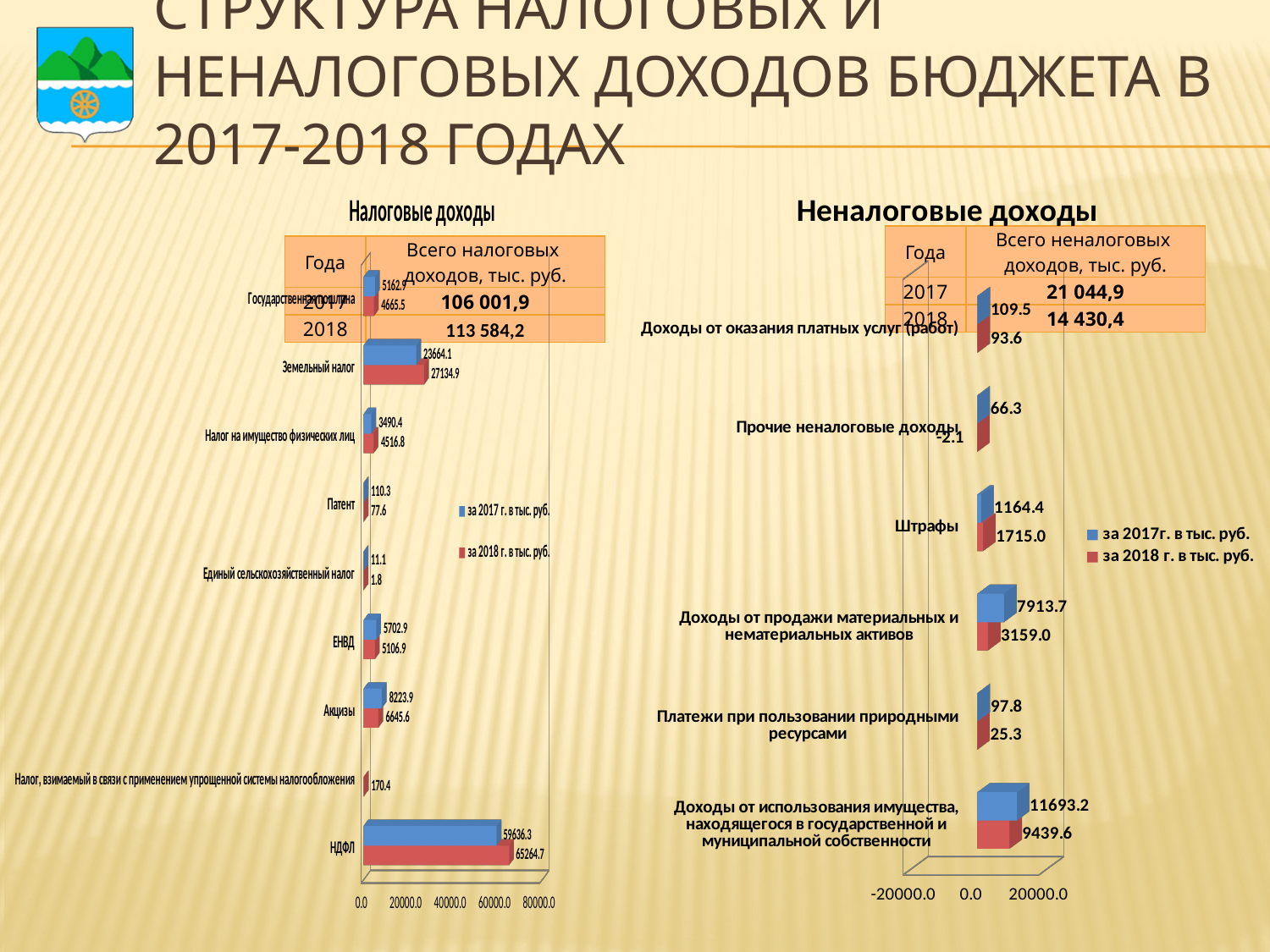
What kind of chart is the 'Неналоговые доходы' chart? Bar chart On the 'Налоговые доходы' chart, which category has the highest value for 2017? НДФЛ On the 'Неналоговые доходы' chart, how many categories are shown? 6 On the 'Неналоговые доходы' chart, which category has the highest value for 2017? Доходы от использования имущества, находящегося в государственной и муниципальной собственности On the 'Налоговые доходы' chart, how many series does the legend list? 2 On the 'Неналоговые доходы' chart, what is the value for Прочие неналоговые доходы for 2018? -2.1 On the 'Налоговые доходы' chart, what is the value for Земельный налог for 2017? 23664.1 On the 'Налоговые доходы' chart, what is the difference between the 2018 and 2017 values for НДФЛ? 5628.4 On the 'Налоговые доходы' chart, what is the value for НДФЛ for 2018 (за 2018 г. в тыс. руб.)? 65264.7 According to the table on the 'Неналоговые доходы' side, what is the total of non-tax revenues (Всего неналоговых доходов) for 2017? 21 044,9 On the 'Неналоговые доходы' chart, what is the value for Штрафы for 2018? 1715.0 On the 'Налоговые доходы' chart, which is larger for Акцизы: the 2017 value or the 2018 value? 2017 (8223.9)